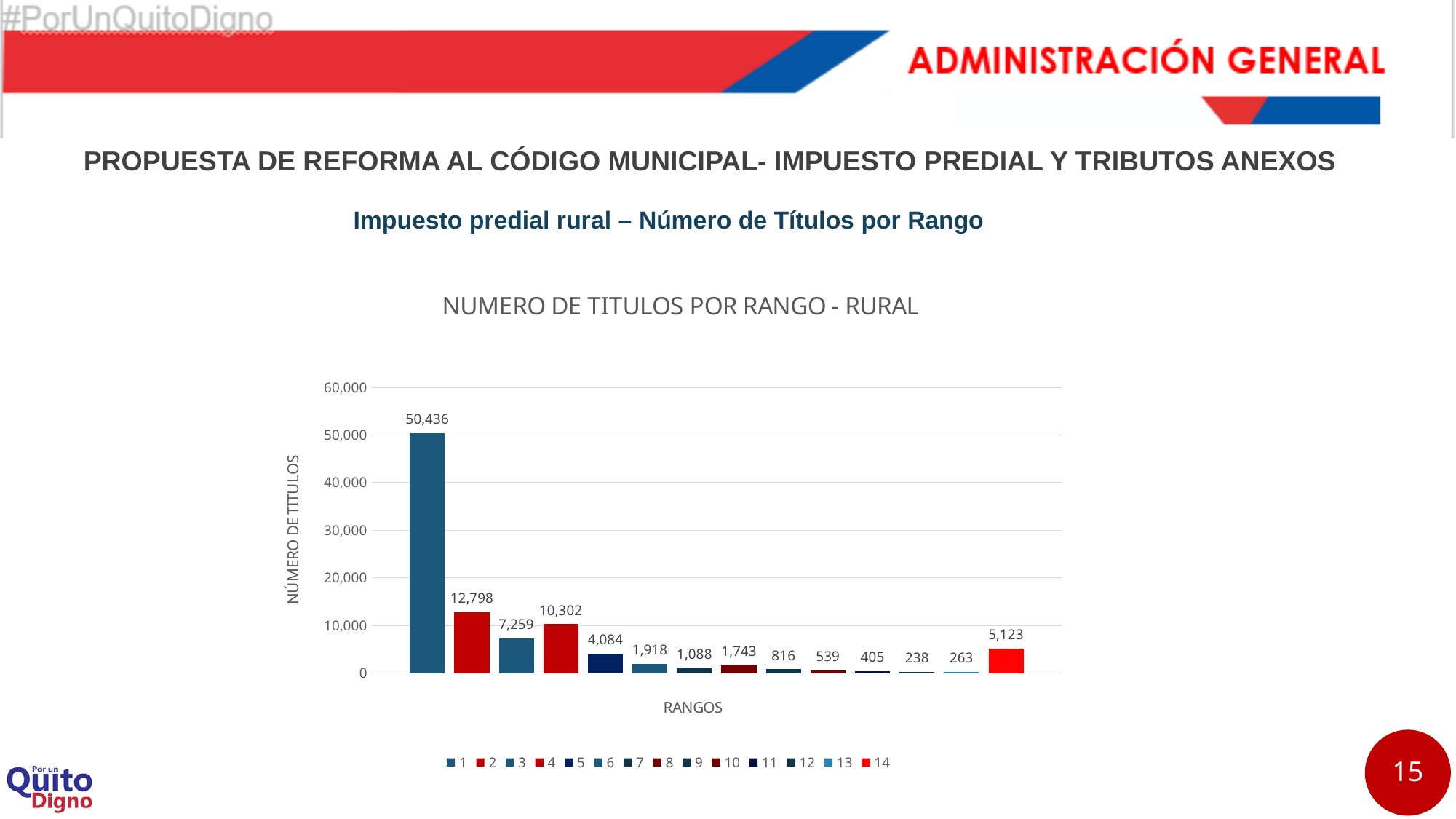
What is the number of titles for range 1? 50,436 What is the number of titles for range 14? 5,123 How many ranges are plotted in the chart? 14 Is the value for range 2 greater or less than 10,000? greater Which range has the lowest number of titles? 12 What is the number of titles for range 4? 10,302 How many entries does the legend list? 14 Which range has the highest number of titles? 1 Which has more titles, range 8 or range 9? Range 8 What is the title of the chart? NUMERO DE TITULOS POR RANGO - RURAL What is the difference between the number of titles for range 2 and range 3? 5,539 What kind of chart is shown on the slide? Bar chart